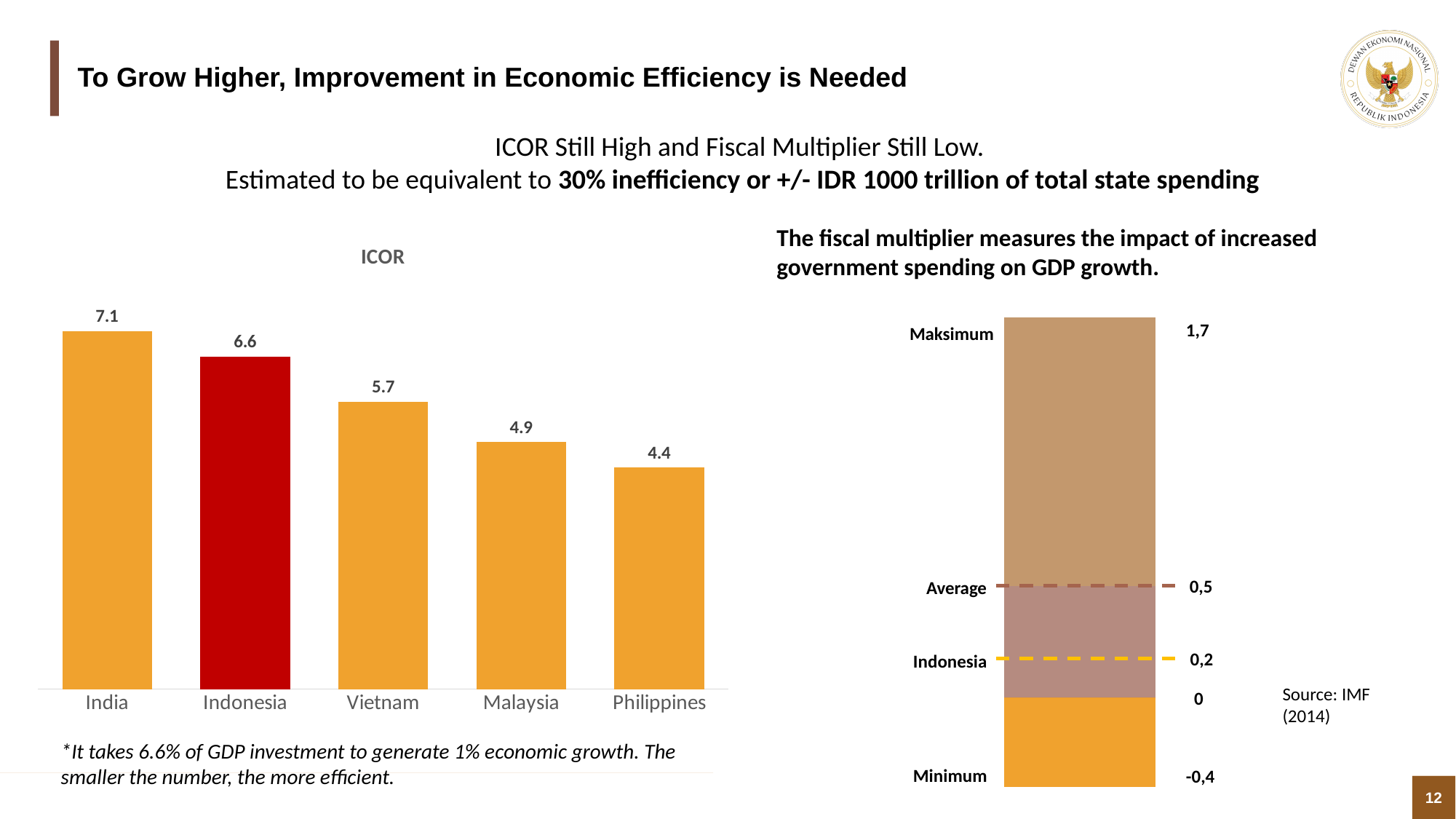
In the ICOR chart, what is the difference between the ICOR of India and Vietnam? 1.4 In the ICOR chart, what is the ICOR value for India? 7.1 In the ICOR chart, which country's bar is coloured red? Indonesia In the ICOR chart, what is the ICOR value for Malaysia? 4.9 In the ICOR chart, which country has the lowest ICOR? Philippines What type of chart is the ICOR chart? Bar chart In the ICOR chart, which country has the highest ICOR? India In the fiscal multiplier chart on the right, what is the value for Indonesia? 0,2 In the ICOR chart, do the values rise or fall from left to right? Fall How many countries are shown in the ICOR chart? 5 In the ICOR chart, what is the ICOR value for Indonesia? 6.6 In the ICOR chart, which has a higher ICOR, Indonesia or Malaysia? Indonesia